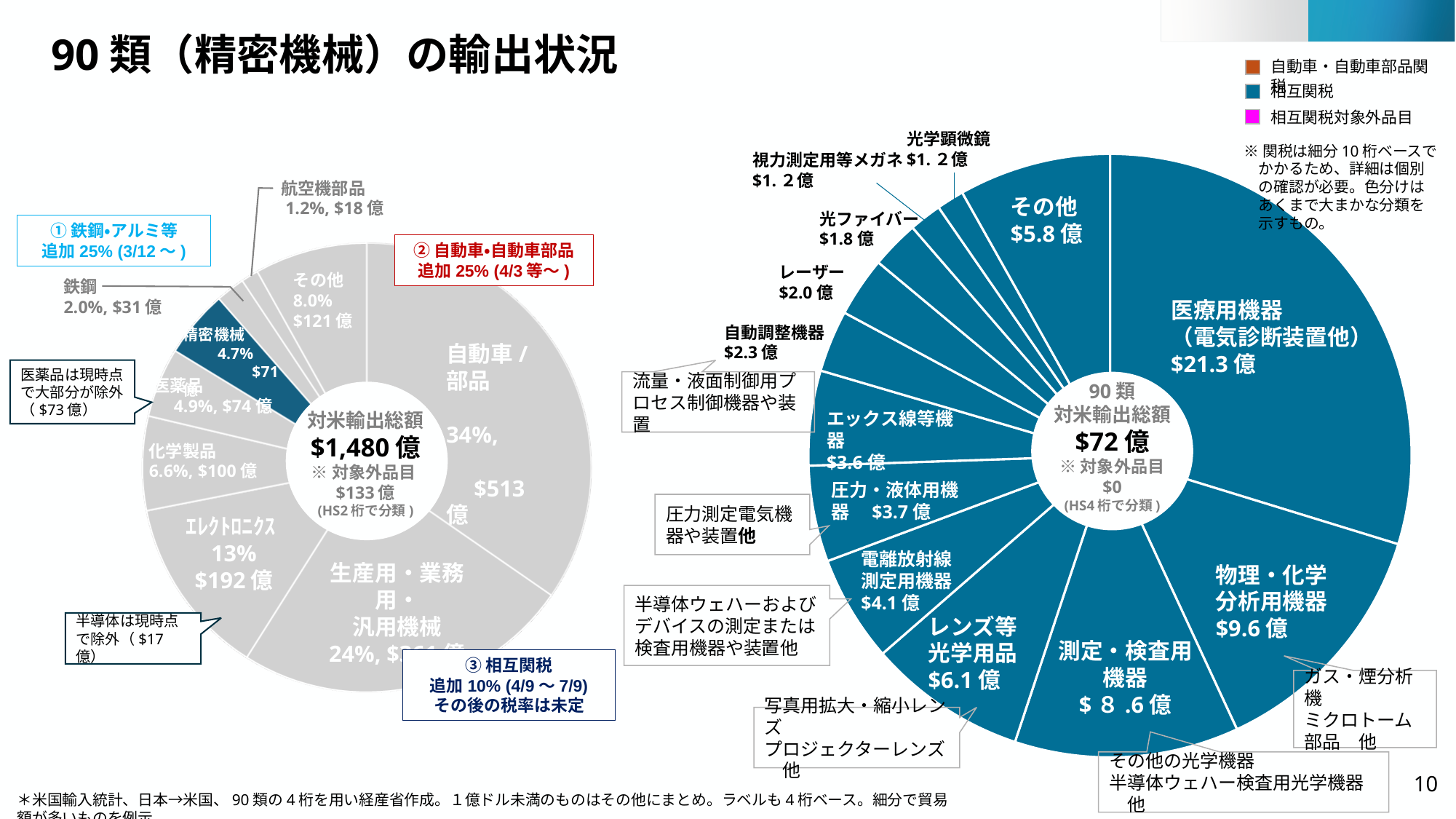
In the right chart (90類 対米輸出総額 $72億), what is the value shown for 測定・検査用機器? $8.6 億 In the left chart (対米輸出総額 $1,480億), which category has the smallest share? 航空機部品 In the left chart (対米輸出総額 $1,480億), what share is shown for エレクトロニクス? 13% In the left chart (対米輸出総額 $1,480億), what is the value shown for 化学製品? 6.6%, $100 億 In the right chart (90類 対米輸出総額 $72億), which is larger, レーザー or 光ファイバー? レーザー In the right chart (90類 対米輸出総額 $72億), which category has the largest value? 医療用機器（電気診断装置他） What kind of chart is used on the right side of the slide (90類 対米輸出総額 $72億)? Pie (donut) chart In the right chart (90類 対米輸出総額 $72億), what is the value shown for 医療用機器（電気診断装置他）? $21.3 億 In the left chart (対米輸出総額 $1,480億), what is the difference in 億 dollars between 医薬品 ($74 億) and 精密機械 ($71 億)? $3 億 In the left chart (対米輸出総額 $1,480億), what is the value shown for 自動車/部品? 34%, $513 億 In the right chart (90類 対米輸出総額 $72億), what is the difference between 物理・化学分析用機器 ($9.6 億) and レンズ等光学用品 ($6.1 億)? $3.5 億 In the left chart (対米輸出総額 $1,480億), which is larger, 医薬品 or 鉄鋼? 医薬品